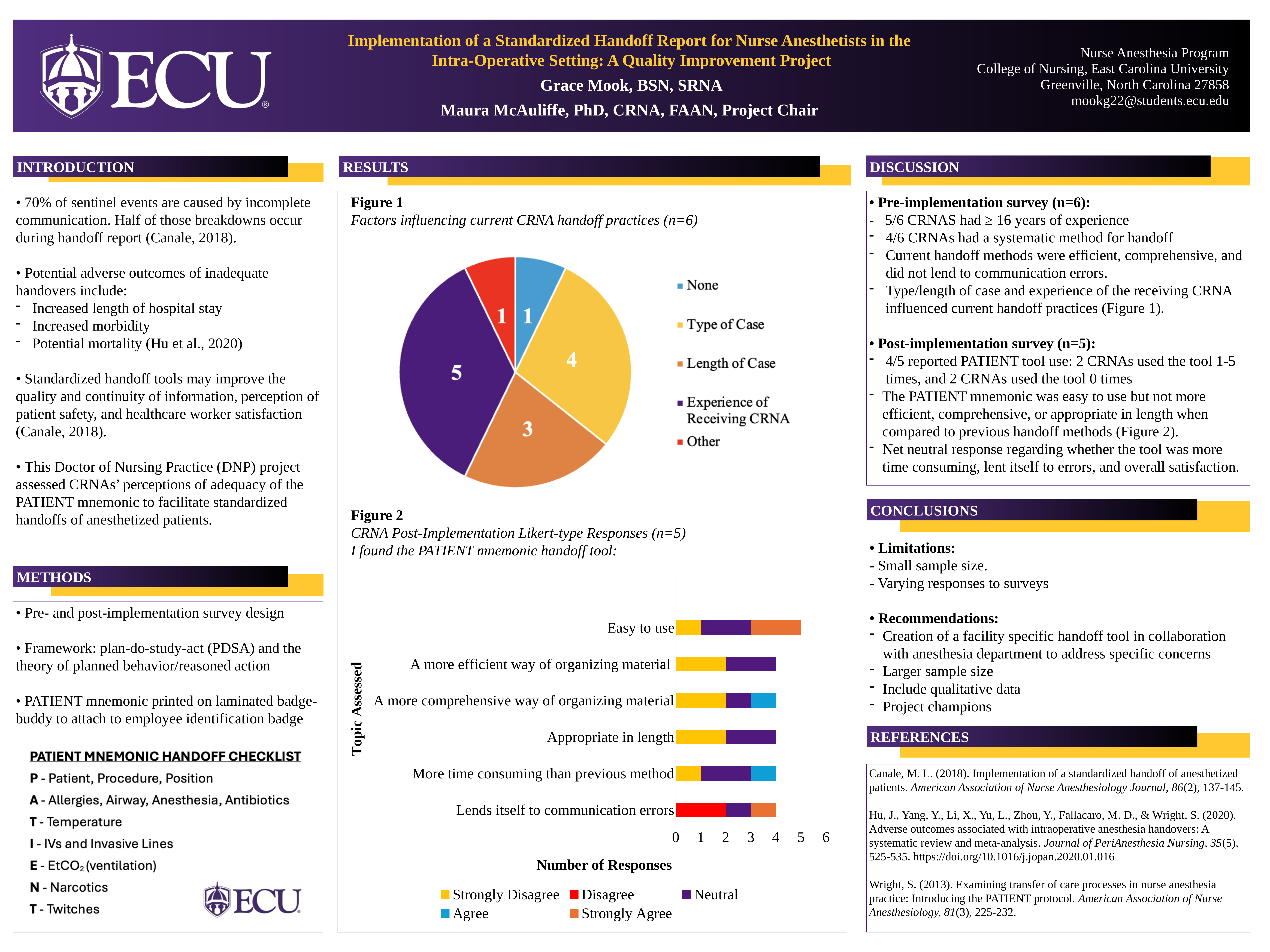
In Figure 1, what is the value for Type of Case? 4 In Figure 2, what is the total number of responses for Easy to use? 5 In Figure 1, how many categories does the pie chart show? 5 In Figure 1, what is the difference between the values for Experience of Receiving CRNA and Length of Case? 2 What kind of chart is Figure 1 (Factors influencing current CRNA handoff practices)? Pie chart In Figure 1, which category has the largest slice? Experience of Receiving CRNA What kind of chart is Figure 2 (CRNA Post-Implementation Likert-type Responses)? Bar chart In Figure 1, which is larger: Type of Case or Length of Case? Type of Case In Figure 2, how many series does the legend list? 5 In Figure 1, what is the value for Other? 1 In Figure 2, how many topics are assessed on the y axis? 6 In Figure 2, which topic has the highest total number of responses? Easy to use